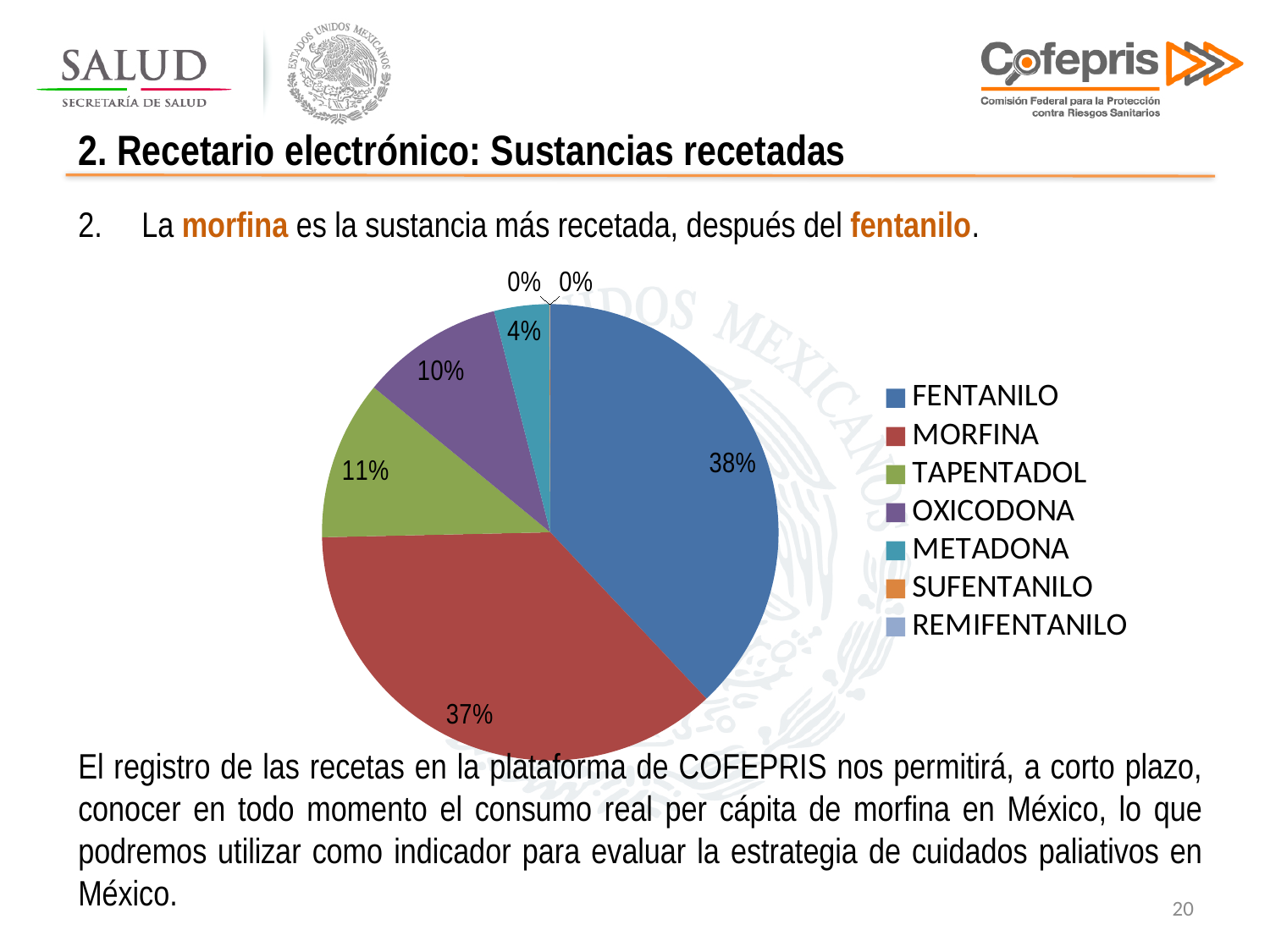
What is the difference in percentage points between TAPENTADOL and METADONA? 7% What kind of chart is shown on the slide? Pie chart What is the difference in percentage points between FENTANILO and MORFINA? 1% Which has a larger share, OXICODONA or METADONA? OXICODONA What percentage is shown for OXICODONA? 10% What percentage is shown for METADONA? 4% What share of the pie does MORFINA have? 37% Which substance has the largest slice of the pie? FENTANILO What share of the pie does FENTANILO have? 38% How many substances are listed in the legend of the pie chart? 7 What colour is the MORFINA slice in the pie chart? Red What percentage is shown for TAPENTADOL? 11%